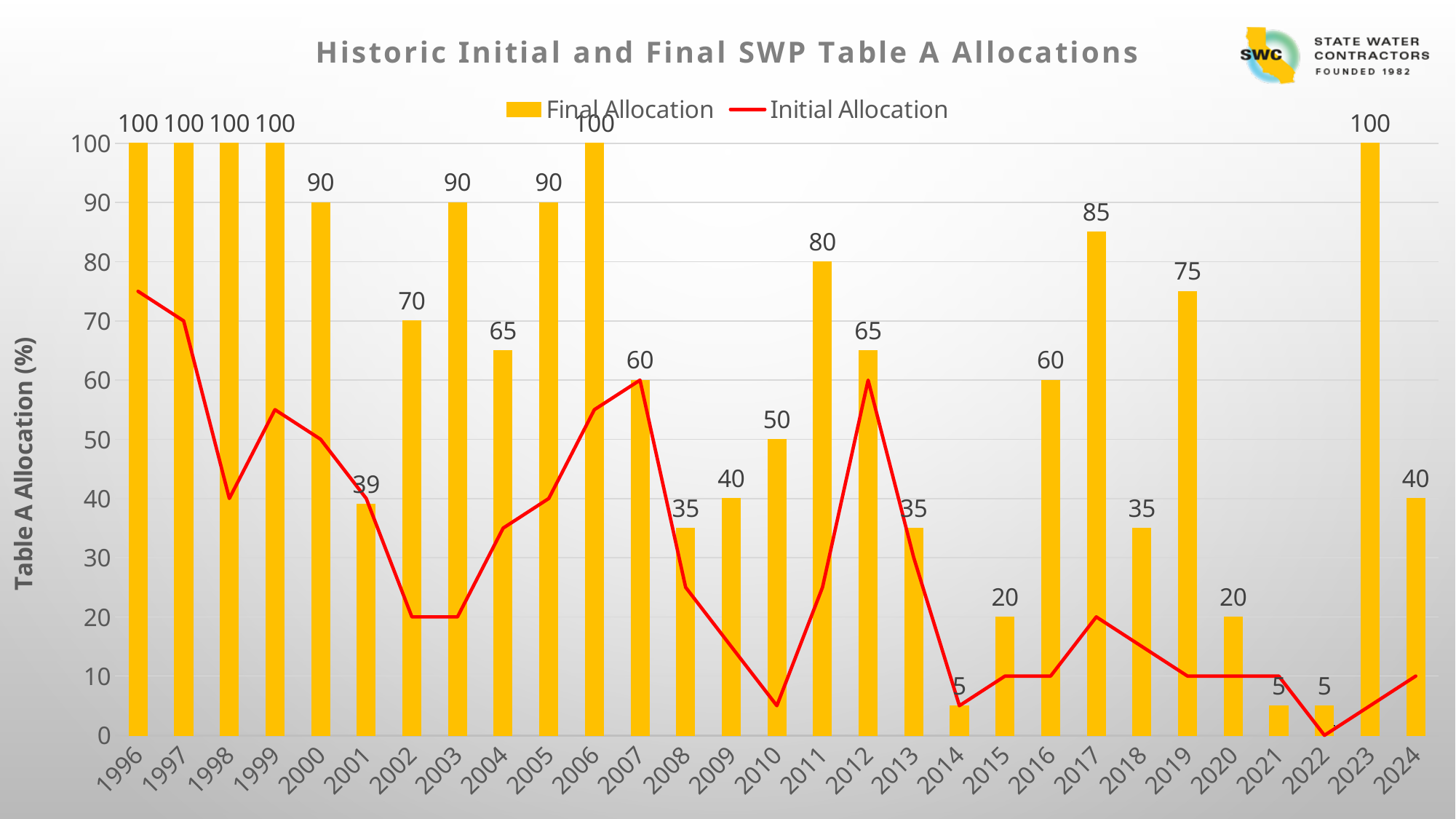
How many years have a Final Allocation of 100? 6 What is the Final Allocation value for 2017? 85 How many series does the legend list? 2 What is the Final Allocation value for 2001? 39 Which year has the larger Final Allocation, 2011 or 2012? 2011 Is the Initial Allocation value for 2008 greater or less than 30? less What is the Final Allocation value for 2024? 40 Does the Final Allocation rise or fall from 2014 to 2017? rise Is the Initial Allocation value for 1996 greater or less than 70? greater What is the difference between the Final Allocation for 2019 and for 2020? 55 What is the lowest Final Allocation value shown on the chart? 5 How many years are shown on the x axis? 29